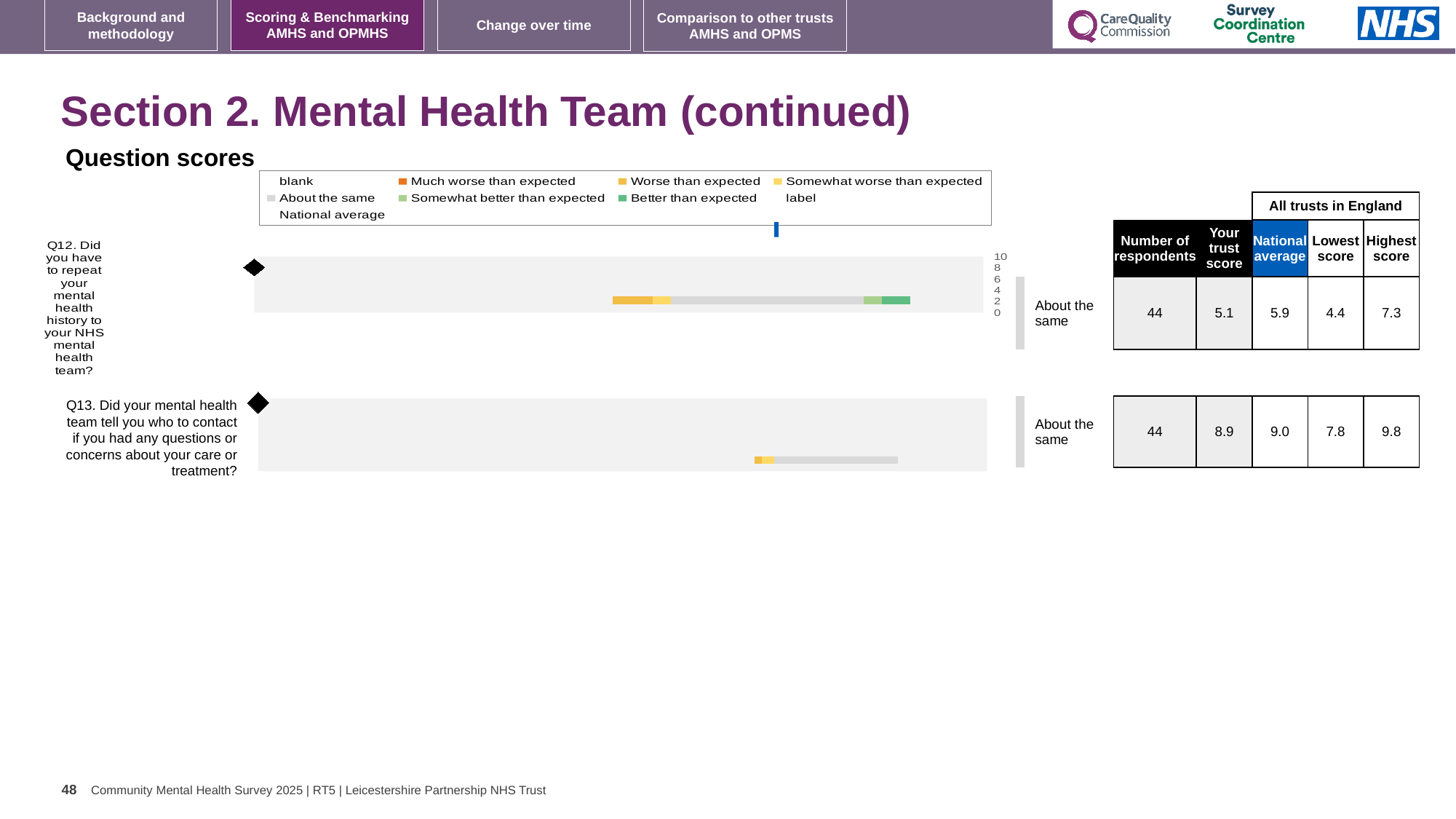
For Q12, how much higher is the national average than the trust score? 0.8 What colour does the legend use for 'Better than expected'? Green What is the national average for Q13 (told who to contact with questions or concerns)? 9.0 How many questions (Q12 and Q13) have a chart on this slide? 2 For Q12, which is larger: the trust score or the national average? National average What is the highest score among all trusts in England for Q13? 9.8 How many respondents answered Q12? 44 What benchmark category is shown next to the Q13 chart? About the same What kind of chart is used to show the Q12 score on the slide? bar chart What is the trust score for Q12 (repeating mental health history)? 5.1 For Q13, what is the difference between the highest score and the lowest score? 2.0 What is the lowest score among all trusts in England for Q12? 4.4